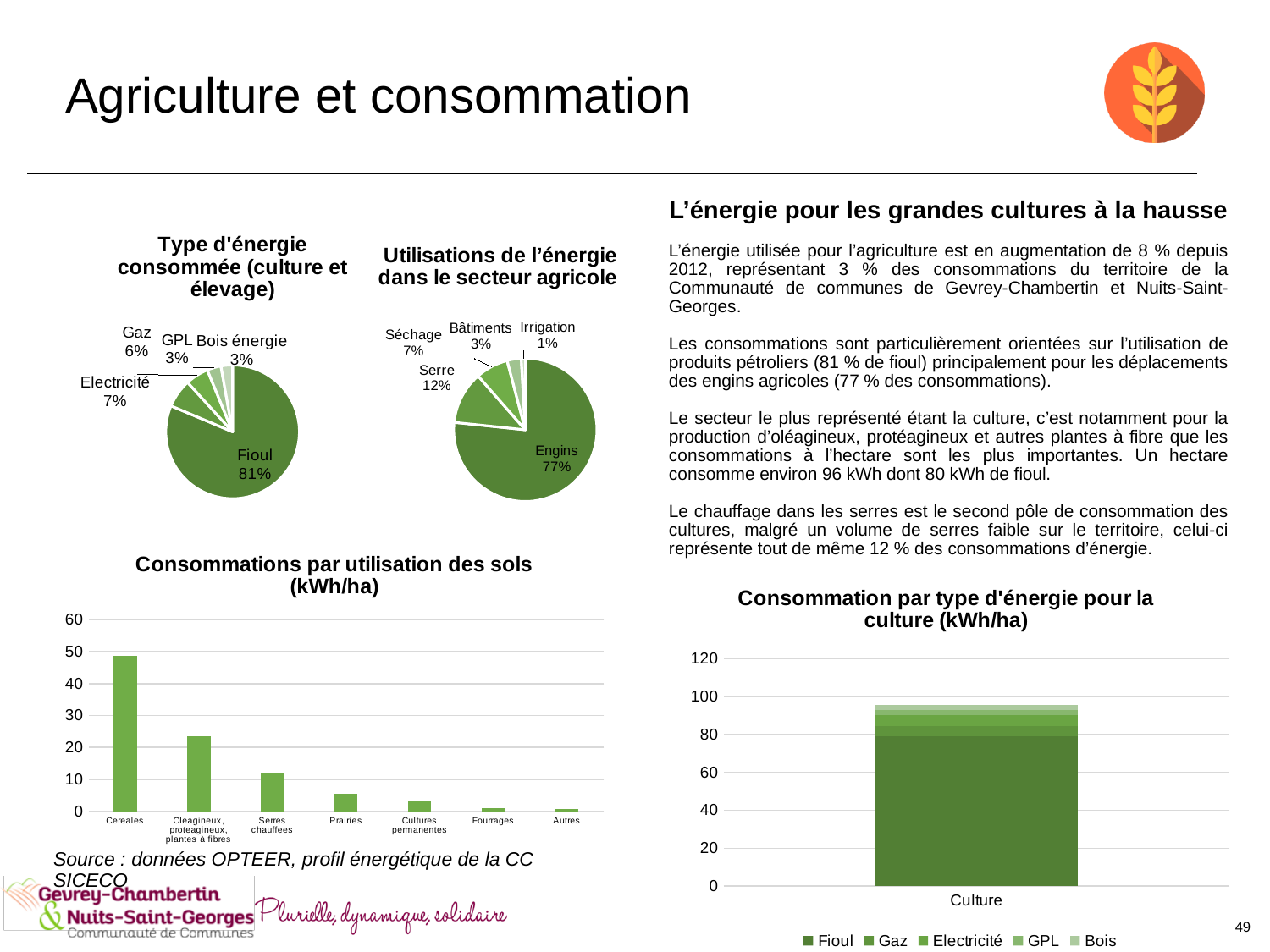
In the chart 'Consommation par type d'énergie pour la culture (kWh/ha)', how many series does the legend list? 5 In the pie chart 'Type d'énergie consommée (culture et élevage)', what share is Electricité? 7% In the chart 'Consommations par utilisation des sols (kWh/ha)', how many categories are shown on the x axis? 7 In the chart 'Consommations par utilisation des sols (kWh/ha)', is the value for Cereales greater or less than 40? greater In the pie chart 'Type d'énergie consommée (culture et élevage)', what is the difference in percentage points between Fioul and Gaz? 75 In the chart 'Consommations par utilisation des sols (kWh/ha)', which category has the highest value? Cereales In the pie chart 'Utilisations de l'énergie dans le secteur agricole', which category has the smallest share? Irrigation In the pie chart 'Utilisations de l'énergie dans le secteur agricole', which category has the largest share? Engins In the pie chart 'Utilisations de l'énergie dans le secteur agricole', which is larger, Séchage or Bâtiments? Séchage In the pie chart 'Type d'énergie consommée (culture et élevage)', what share is Fioul? 81% In the pie chart 'Utilisations de l'énergie dans le secteur agricole', what share is Serre? 12% What kind of chart is 'Consommations par utilisation des sols (kWh/ha)'? Bar chart